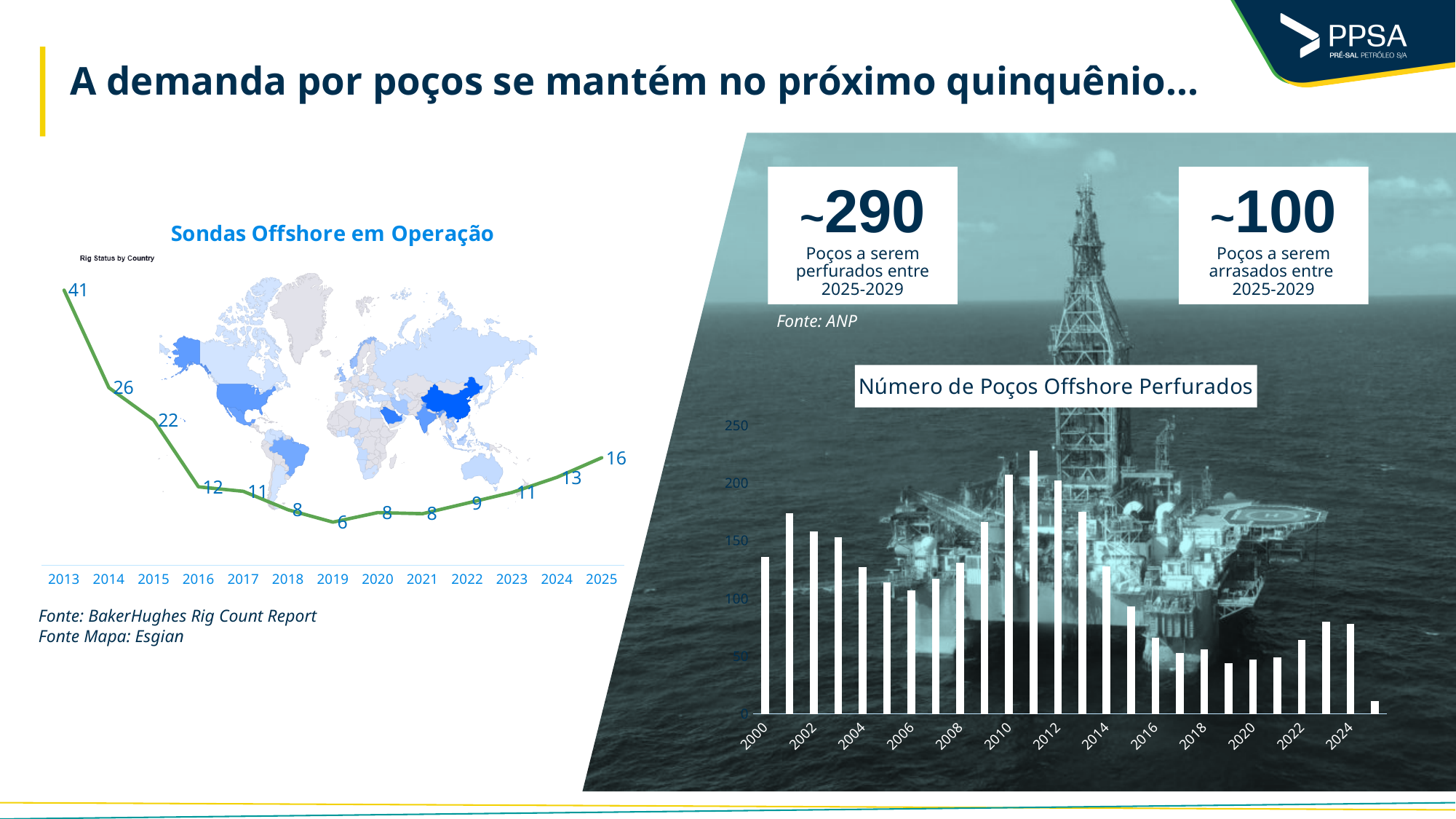
In the 'Sondas Offshore em Operação' chart, what is the value for 2025? 16 How many years are plotted in the 'Sondas Offshore em Operação' chart? 13 In the 'Sondas Offshore em Operação' chart, do the values rise or fall from 2013 to 2019? fall What kind of chart is 'Sondas Offshore em Operação'? line chart In the 'Número de Poços Offshore Perfurados' chart, is the value for 2011 greater or less than 200? greater In the 'Sondas Offshore em Operação' chart, which year has the lowest value? 2019 In the 'Sondas Offshore em Operação' chart, what is the difference between the values for 2013 and 2014? 15 In the 'Sondas Offshore em Operação' chart, what is the value for 2019? 6 In the 'Sondas Offshore em Operação' chart, which is larger, the value for 2018 or the value for 2024? 2024 In the 'Sondas Offshore em Operação' chart, what is the value for 2013? 41 In the 'Sondas Offshore em Operação' chart, which year has the highest value? 2013 What kind of chart is 'Número de Poços Offshore Perfurados'? bar chart